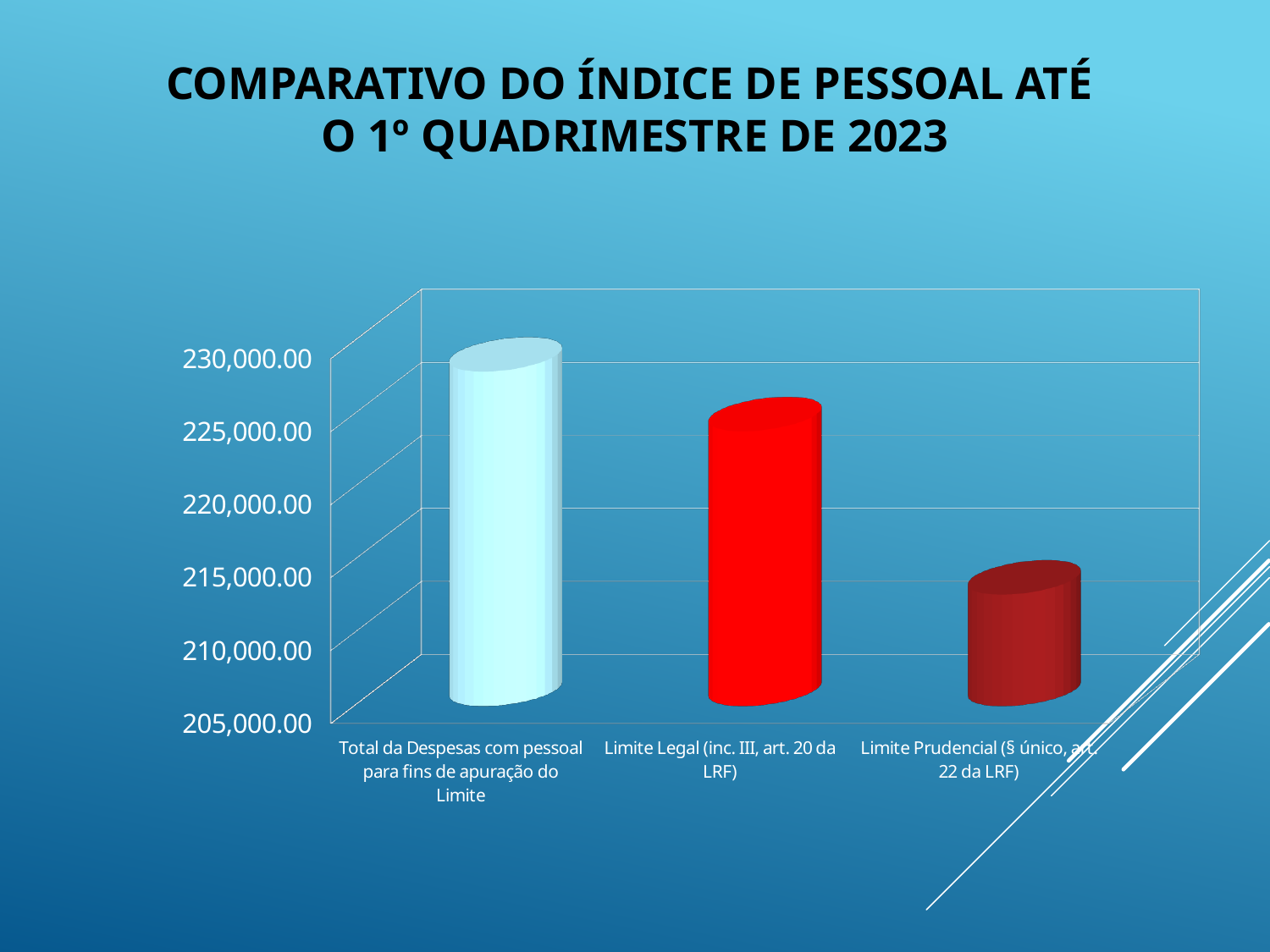
How many categories are plotted in the chart? 3 What kind of chart is shown on the slide? bar chart Which is larger: the value for Limite Legal (inc. III, art. 20 da LRF) or the value for Limite Prudencial (§ único, art. 22 da LRF)? Limite Legal (inc. III, art. 20 da LRF) What is the title of the slide containing the chart? COMPARATIVO DO ÍNDICE DE PESSOAL ATÉ O 1º QUADRIMESTRE DE 2023 Is the value for Limite Prudencial (§ único, art. 22 da LRF) greater or less than 210,000.00? greater Is the value for Limite Prudencial (§ único, art. 22 da LRF) greater or less than 220,000.00? less Which category has the lowest value? Limite Prudencial (§ único, art. 22 da LRF) Is the value for Total da Despesas com pessoal para fins de apuração do Limite greater or less than 225,000.00? greater Which is larger: the value for Total da Despesas com pessoal para fins de apuração do Limite or the value for Limite Legal (inc. III, art. 20 da LRF)? Total da Despesas com pessoal para fins de apuração do Limite Which category has the highest value? Total da Despesas com pessoal para fins de apuração do Limite Do the values rise or fall from left to right across the categories? fall